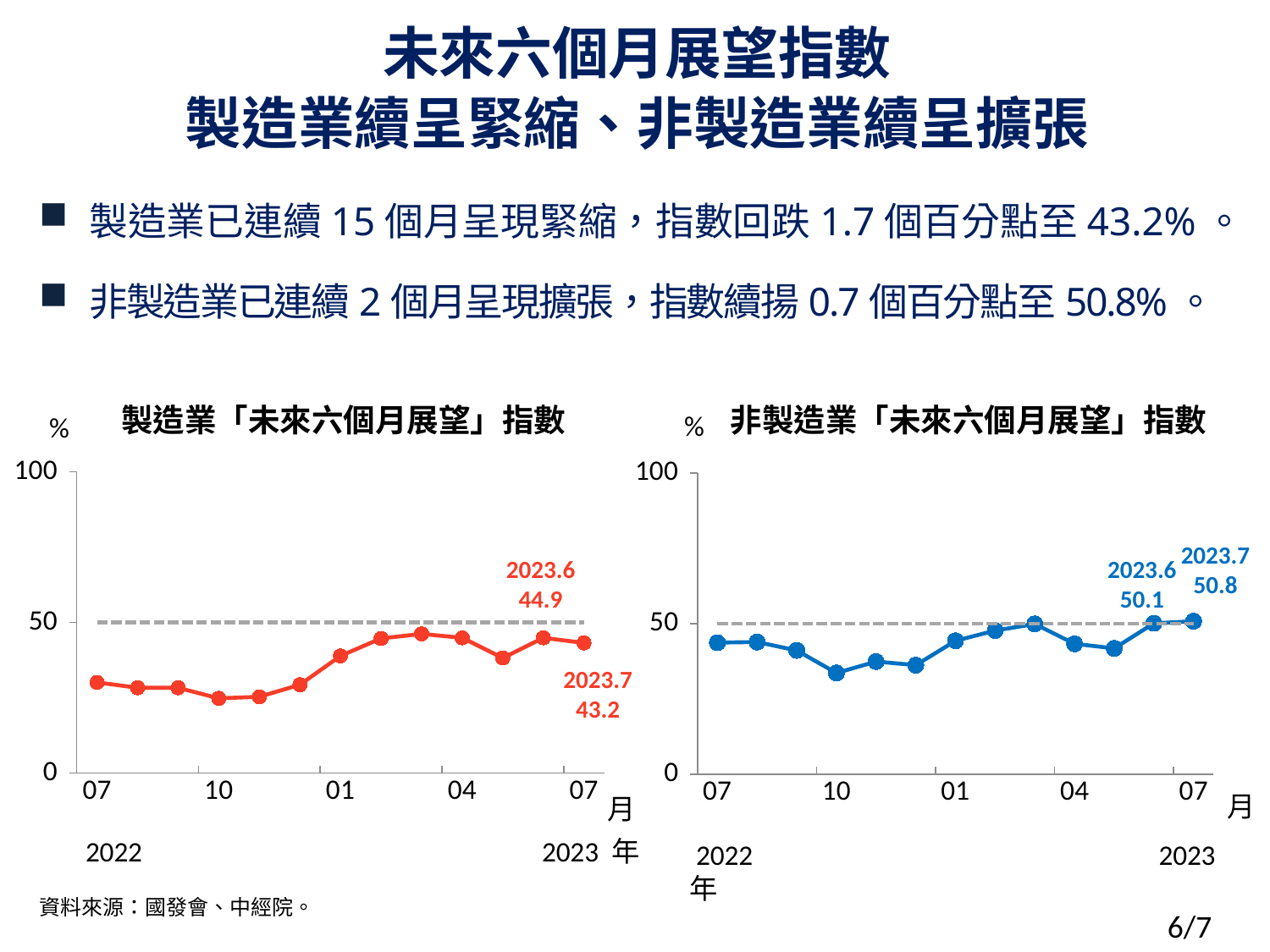
In the 非製造業「未來六個月展望」指數 chart on the right, is the value for 2022.10 greater or less than 50? less In the 製造業「未來六個月展望」指數 chart on the left, is the value for 2022.10 greater or less than 50? less In the 非製造業「未來六個月展望」指數 chart on the right, what is the value labelled for 2023.6? 50.1 In the 製造業「未來六個月展望」指數 chart on the left, what is the value labelled for 2023.7? 43.2 What kind of chart is the 製造業「未來六個月展望」指數 chart on the left? Line chart In the 製造業「未來六個月展望」指數 chart on the left, does the index rise or fall from 2022.10 to 2023.03? rise In the 非製造業「未來六個月展望」指數 chart on the right, what is the value labelled for 2023.7? 50.8 Comparing the two charts, which index is higher in 2023.7: 製造業 or 非製造業? 非製造業 In the 非製造業「未來六個月展望」指數 chart on the right, by how much did the index rise from 2023.6 to 2023.7? 0.7 In the 製造業「未來六個月展望」指數 chart on the left, what is the value labelled for 2023.6? 44.9 How many monthly data points are plotted in the 製造業「未來六個月展望」指數 chart on the left? 13 In the 製造業「未來六個月展望」指數 chart on the left, by how much did the index fall from 2023.6 to 2023.7? 1.7